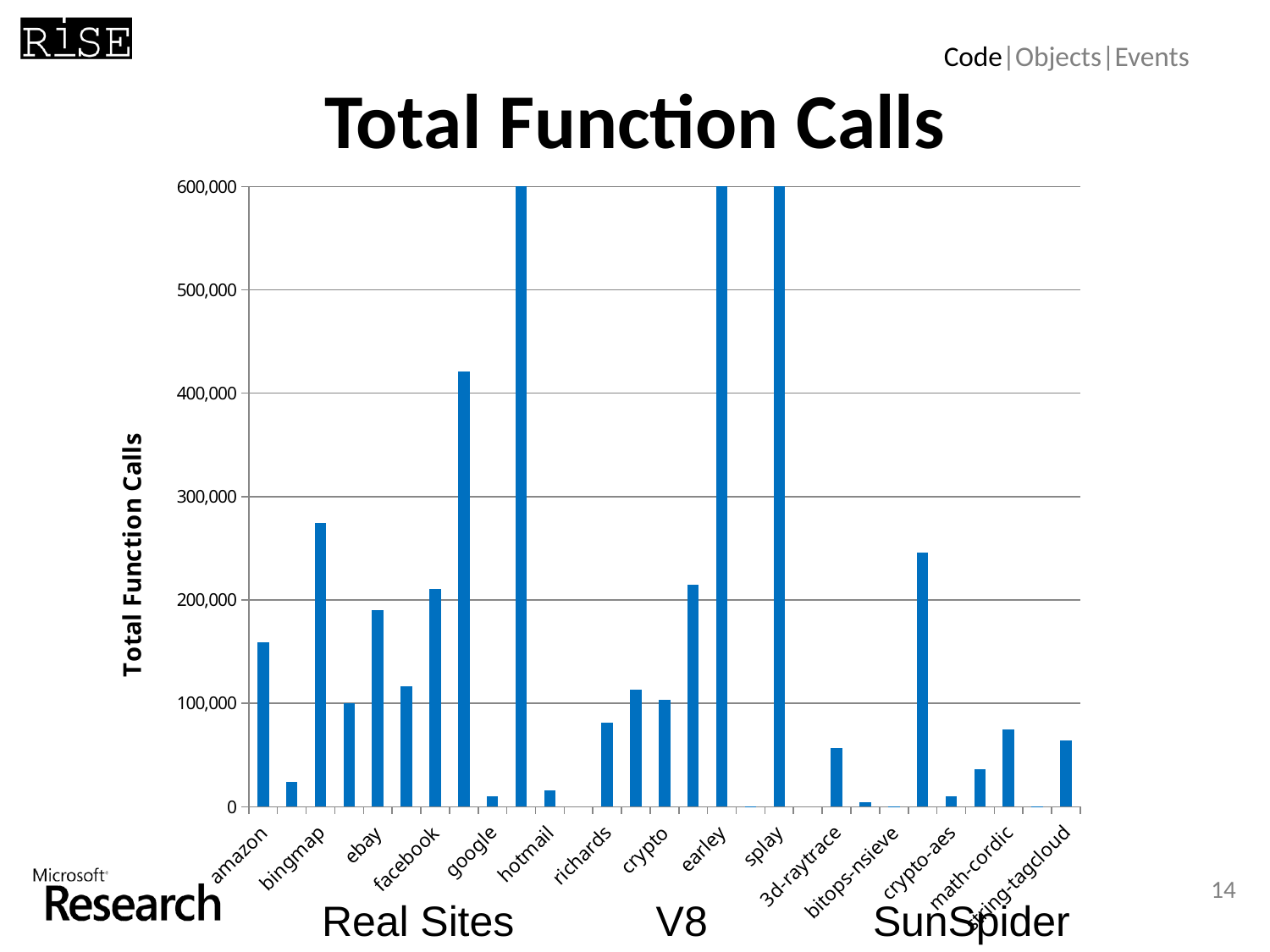
Is the value for bingmap greater or less than 200,000? greater Is the value for splay greater or less than 500,000? greater Is the value for earley greater or less than 500,000? greater Which has more total function calls, bingmap or amazon? bingmap Which has more total function calls, earley or richards? earley What kind of chart is shown on the slide? bar chart What is the label on the vertical axis of the chart? Total Function Calls What is the title of the chart? Total Function Calls